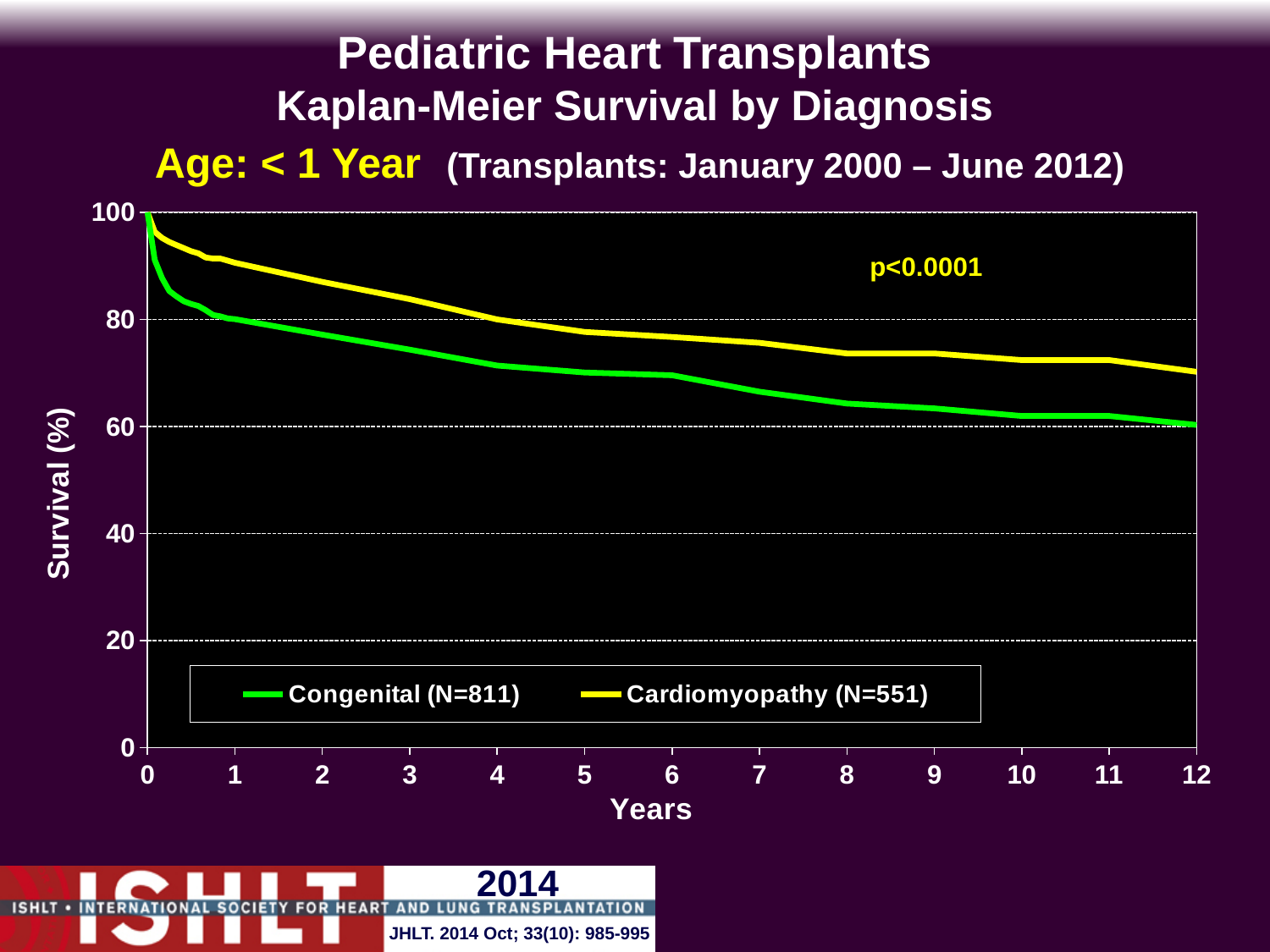
Which series has the higher survival at 6 years, Congenital or Cardiomyopathy? Cardiomyopathy How many series does the legend list? 2 Which diagnosis group shows the lower survival curve across the follow-up period? Congenital Is the survival value for Congenital at 6 years greater or less than 60? greater Is the survival value for Cardiomyopathy at 12 years greater or less than 60? greater What is the maximum value shown on the x axis (Years)? 12 What is the number of patients (N) in the Congenital group according to the legend? 811 Is the survival value for Congenital at 4 years greater or less than 80? less What p-value is printed on the chart? p<0.0001 What kind of chart is shown on the slide? Line chart Do the survival curves rise or fall as years since transplant increase? Fall